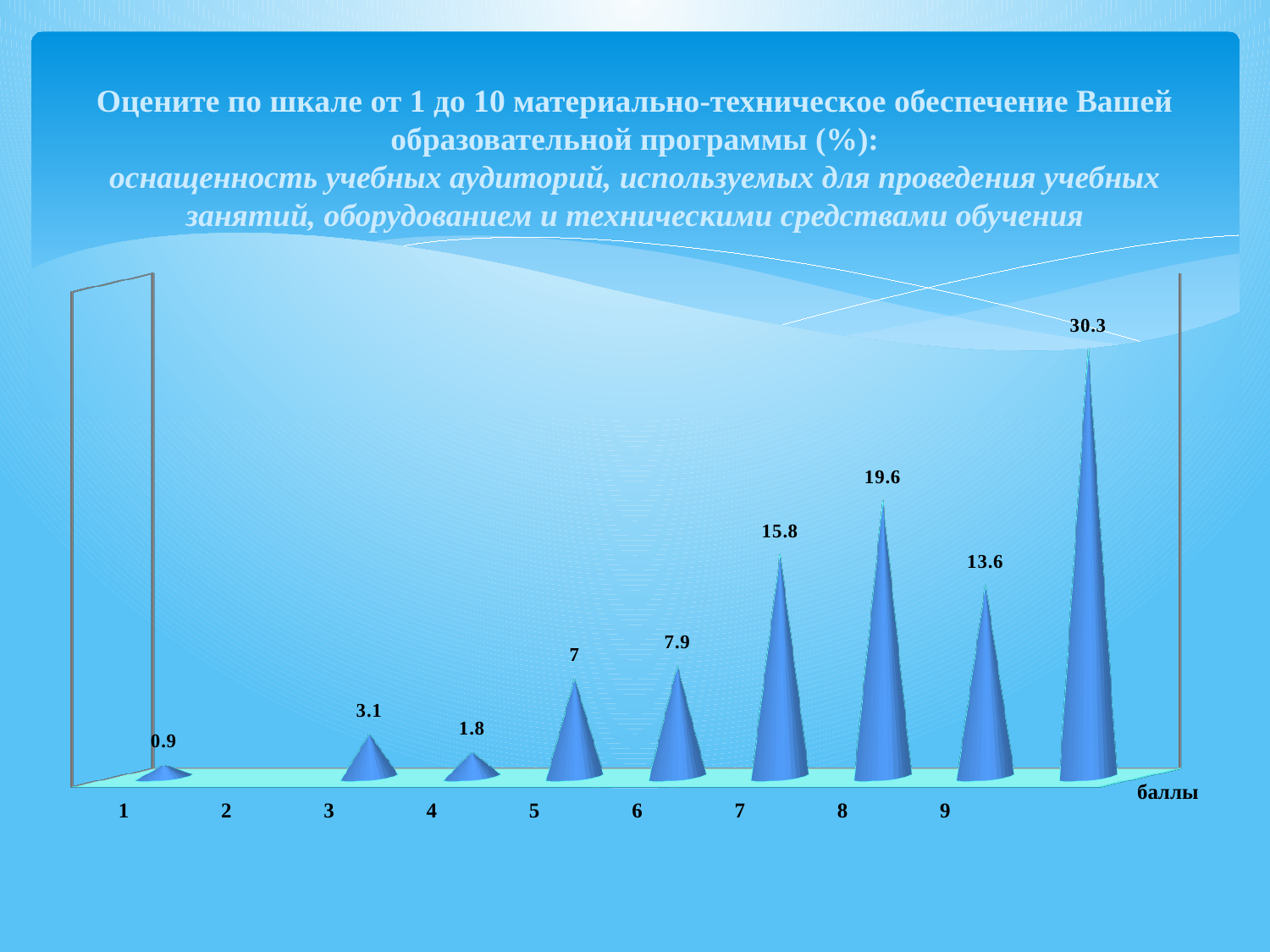
What is the difference between the values for score 8 and score 7? 3.8 What label is shown at the end of the horizontal axis? баллы What is the difference between the highest value (30.3) and the value for score 8? 10.7 Which has the larger value, score 5 or score 6? score 6 What is the value for score 3? 3.1 What is the value for score 8? 19.6 Which has the larger value, score 8 or score 9? score 8 What is the highest value shown in the chart? 30.3 What is the value for score 7? 15.8 What is the value for score 4? 1.8 What kind of chart is shown on the slide? bar chart Which score has the lowest labelled value? 1